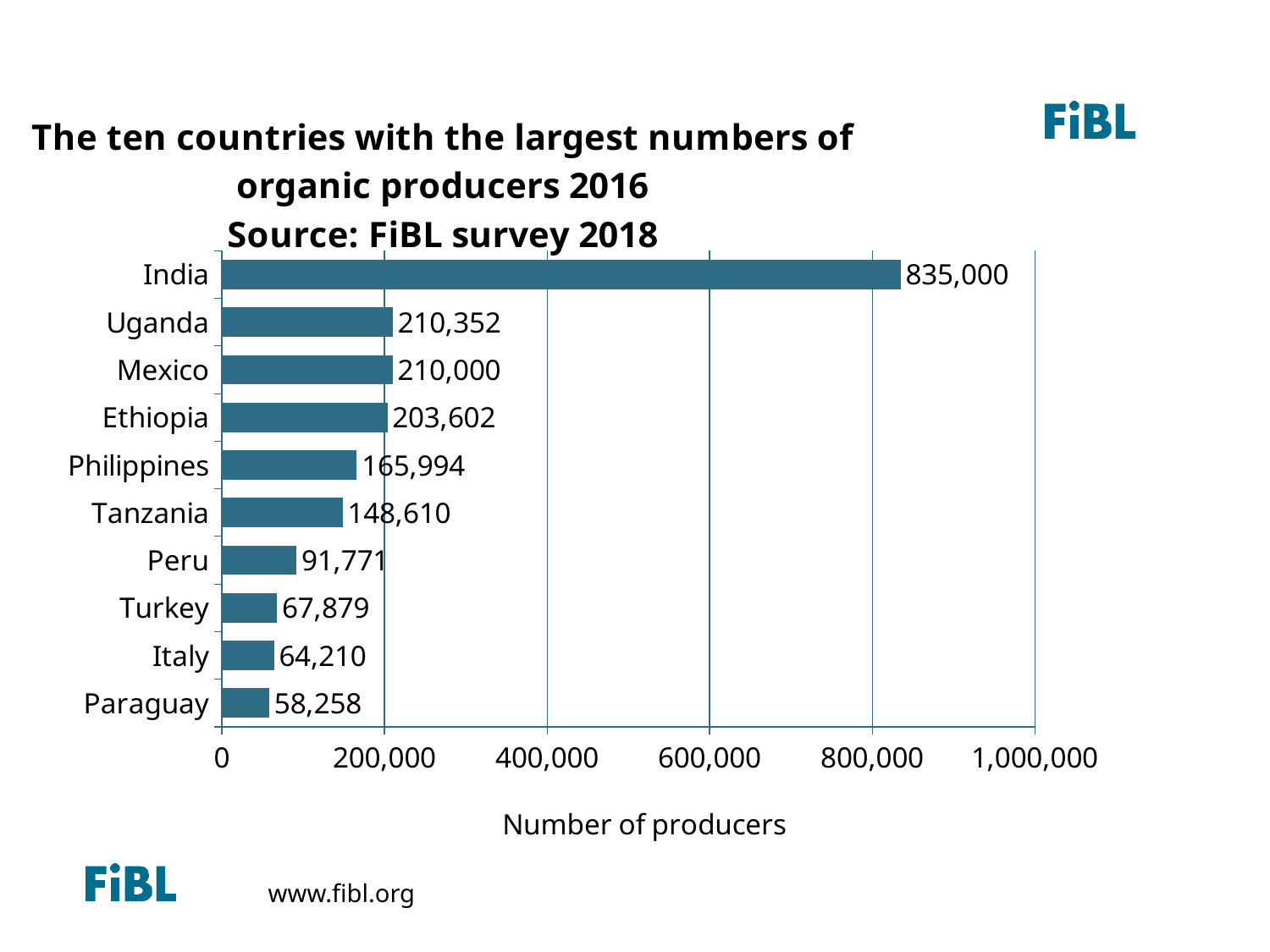
What kind of chart is shown on the slide? Bar chart Which country has the smallest number of organic producers on the chart? Paraguay Which country has the largest number of organic producers on the chart? India Is the value for Tanzania greater or less than 200,000? less How many countries are shown on the chart? 10 Which has more organic producers, the Philippines or Turkey? Philippines What is the number of producers shown for Peru? 91,771 What is the number of producers shown for Ethiopia? 203,602 What is the difference between the number of producers in Uganda and Mexico? 352 What is the label of the horizontal axis? Number of producers How many organic producers does India have according to the chart? 835,000 What is the difference between the number of producers in India and Tanzania? 686,390